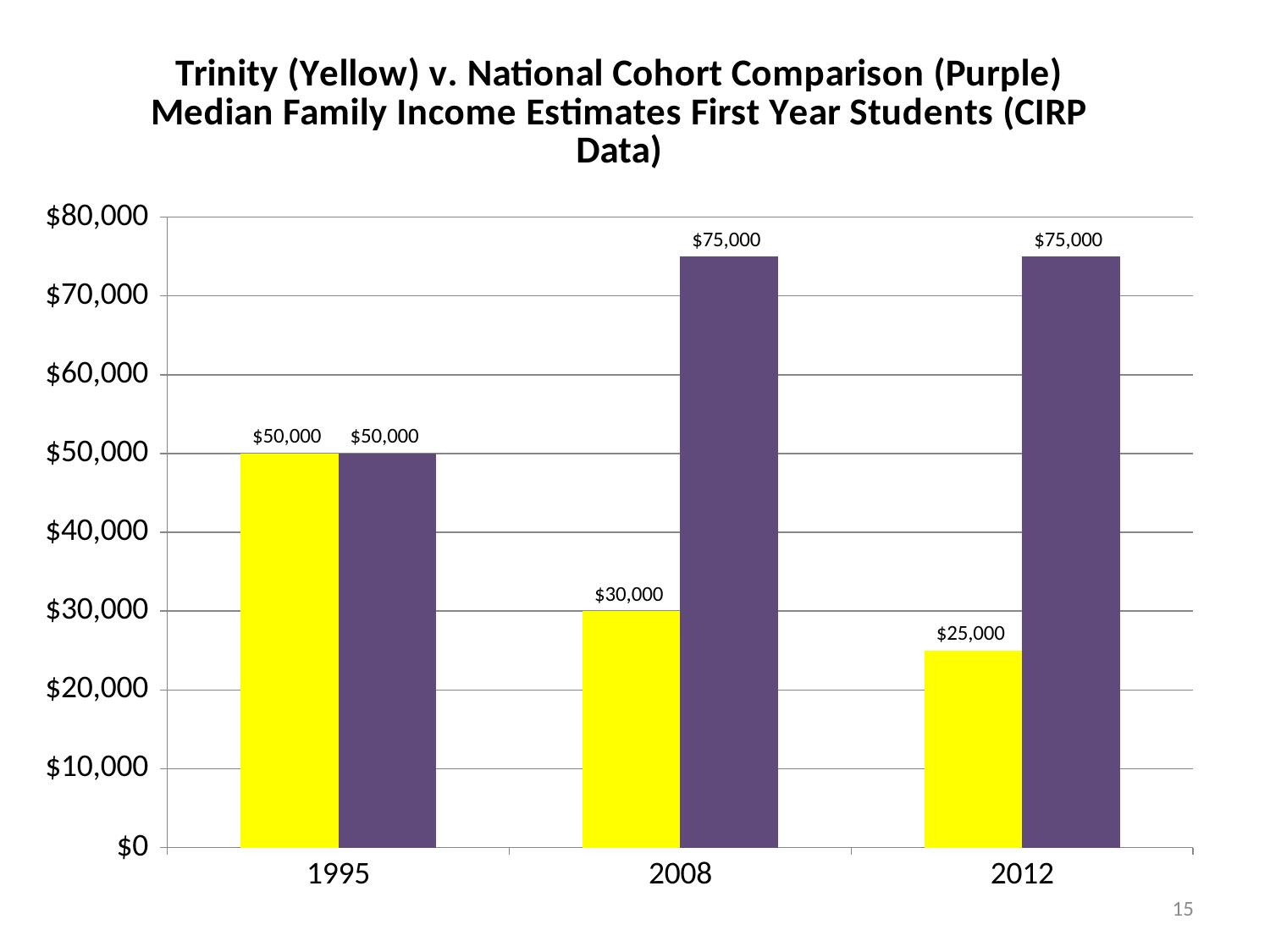
What is the Trinity (yellow) value for 1995? $50,000 What is the difference between the Trinity (yellow) values for 1995 and 2008? $20,000 How many years are shown on the x axis? 3 What is the Trinity (yellow) median family income estimate for 2012? $25,000 What is the difference between the National Cohort (purple) and Trinity (yellow) values in 2012? $50,000 Which is larger in 2008, the Trinity (yellow) value or the National Cohort (purple) value? National Cohort (purple) What is the National Cohort (purple) median family income estimate for 2008? $75,000 In which year is the Trinity (yellow) value highest? 1995 In which year is the Trinity (yellow) value lowest? 2012 Which colour represents the National Cohort in the chart? Purple Do the Trinity (yellow) values rise or fall from 1995 to 2012? Fall What kind of chart is this? Bar chart